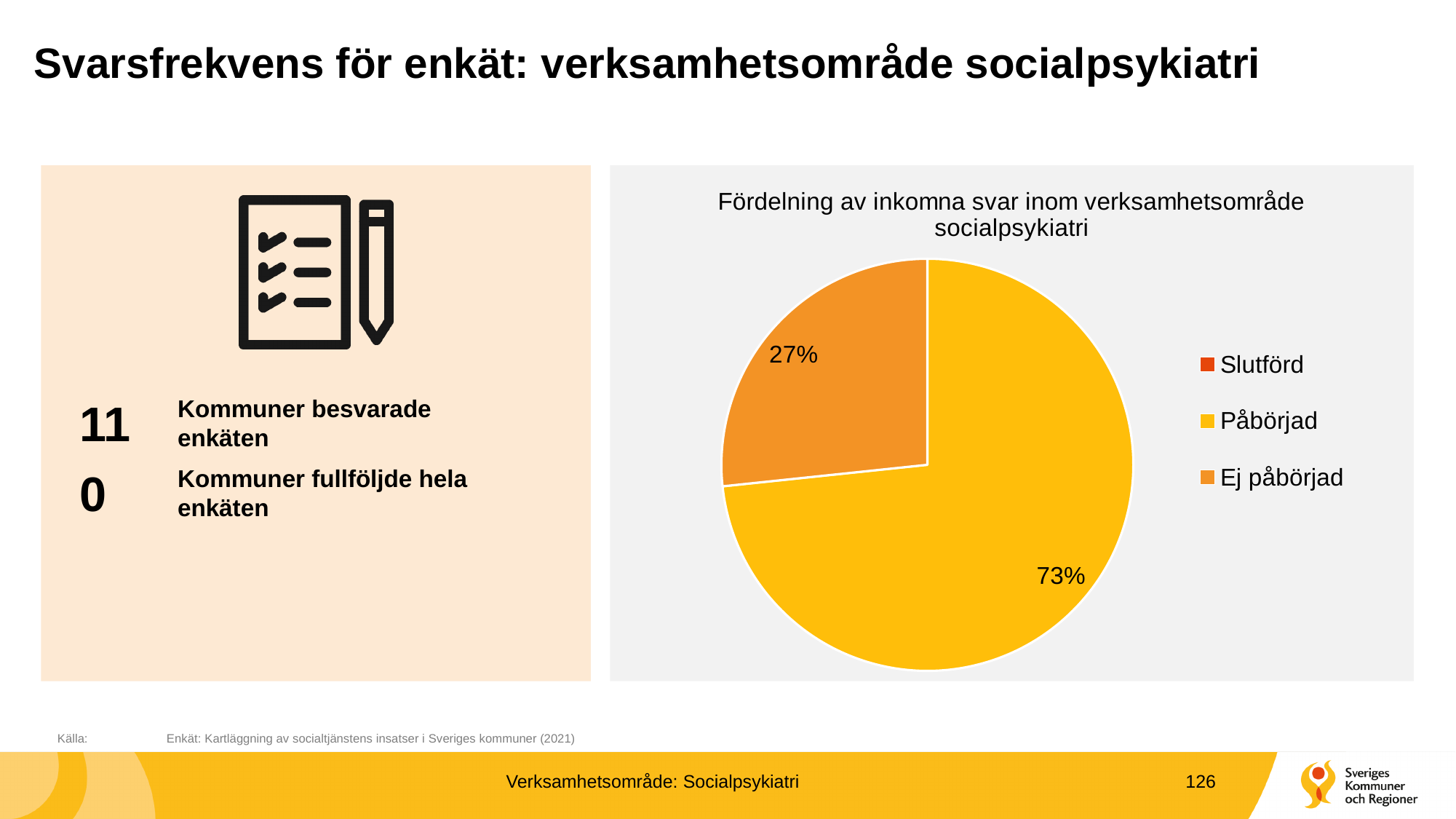
How many entries does the legend list? 3 Which legend entry has no visible slice in the pie? Slutförd Which of the two visible slices is larger, Påbörjad or Ej påbörjad? Påbörjad Is the share for Ej påbörjad greater or less than 50%? less What is the difference in percentage points between the Påbörjad and Ej påbörjad slices? 46 How many slices are visible in the pie chart? 2 What kind of chart is shown on the slide? pie chart What share of the pie does Ej påbörjad have? 27% What share of the pie does Påbörjad have? 73% Is the share for Påbörjad greater or less than 50%? greater Which category has the largest slice of the pie? Påbörjad What is the title of the chart? Fördelning av inkomna svar inom verksamhetsområde socialpsykiatri